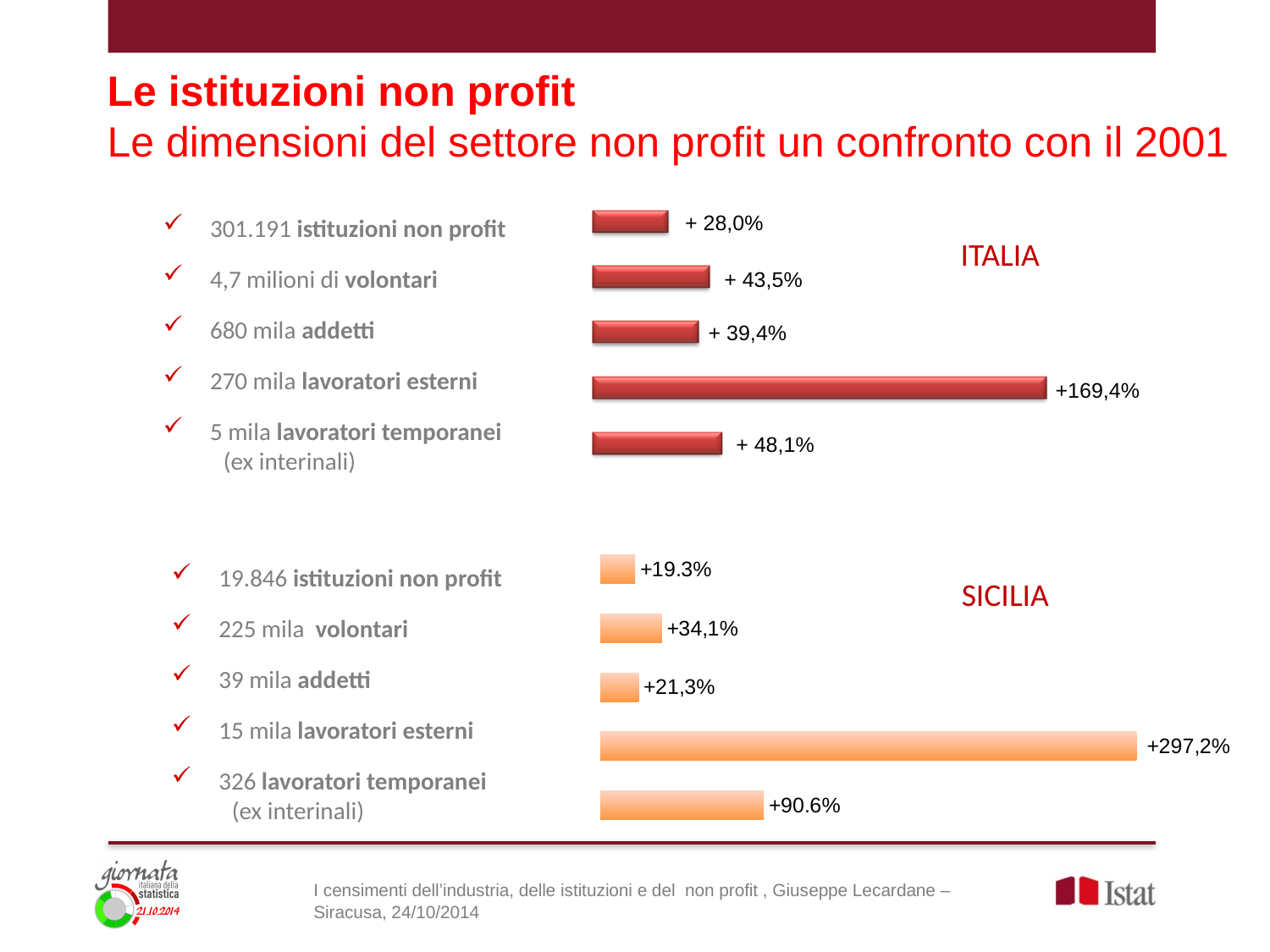
In the SICILIA chart, what is the percentage change shown for volontari? +34,1% In the ITALIA chart, what is the percentage change shown for istituzioni non profit? + 28,0% What colour are the bars in the SICILIA chart? orange In the ITALIA chart, which category has the highest percentage change? lavoratori esterni What type of chart is used for the ITALIA data? bar chart In the SICILIA chart, which is larger: the percentage change for addetti or for volontari? volontari In the ITALIA chart, which category has the lowest percentage change? istituzioni non profit In the SICILIA chart, what is the percentage change shown for lavoratori temporanei (ex interinali)? +90.6% In the ITALIA chart, what is the percentage change shown for lavoratori esterni? +169,4% How many bars does the SICILIA chart show? 5 In the ITALIA chart, what is the difference between the percentage change for volontari and for addetti? 4,1 percentage points In the SICILIA chart, which category has the lowest percentage change? istituzioni non profit